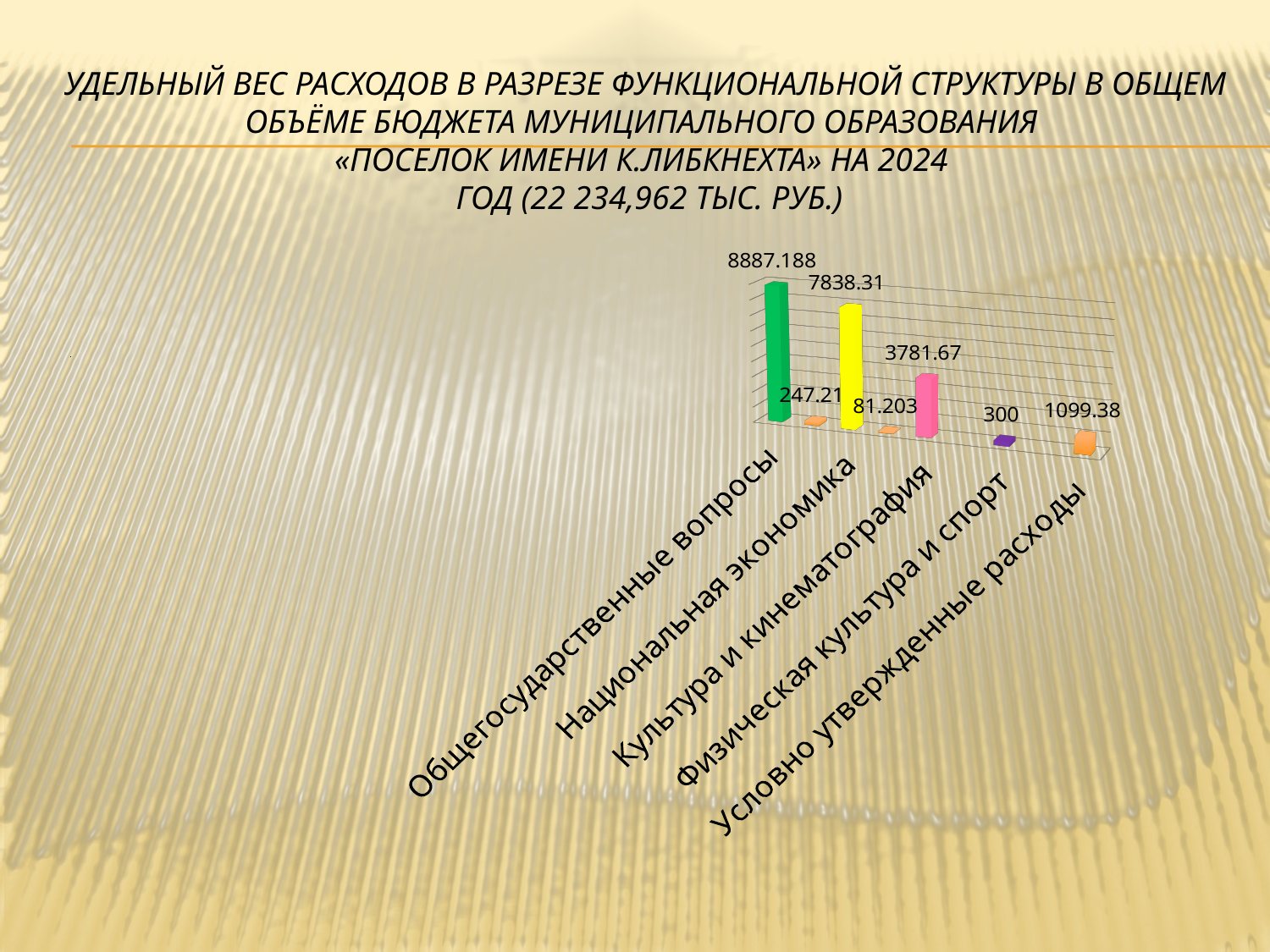
What total budget amount is stated in the slide title? 22 234,962 тыс. руб. How many bars are plotted in the chart? 7 Which category has the highest value in the chart? Общегосударственные вопросы What is the value shown for Национальная экономика? 7838.31 What kind of chart is shown on the slide? bar chart What is the value shown for Общегосударственные вопросы? 8887.188 What is the smallest value labelled on the chart? 81.203 What is the value shown for Физическая культура и спорт? 300 What is the value shown for Культура и кинематография? 3781.67 Which is larger, the value for Условно утвержденные расходы or the value for Физическая культура и спорт? Условно утвержденные расходы What is the difference between the values for Общегосударственные вопросы and Национальная экономика? 1048.878 What is the value shown for Условно утвержденные расходы? 1099.38